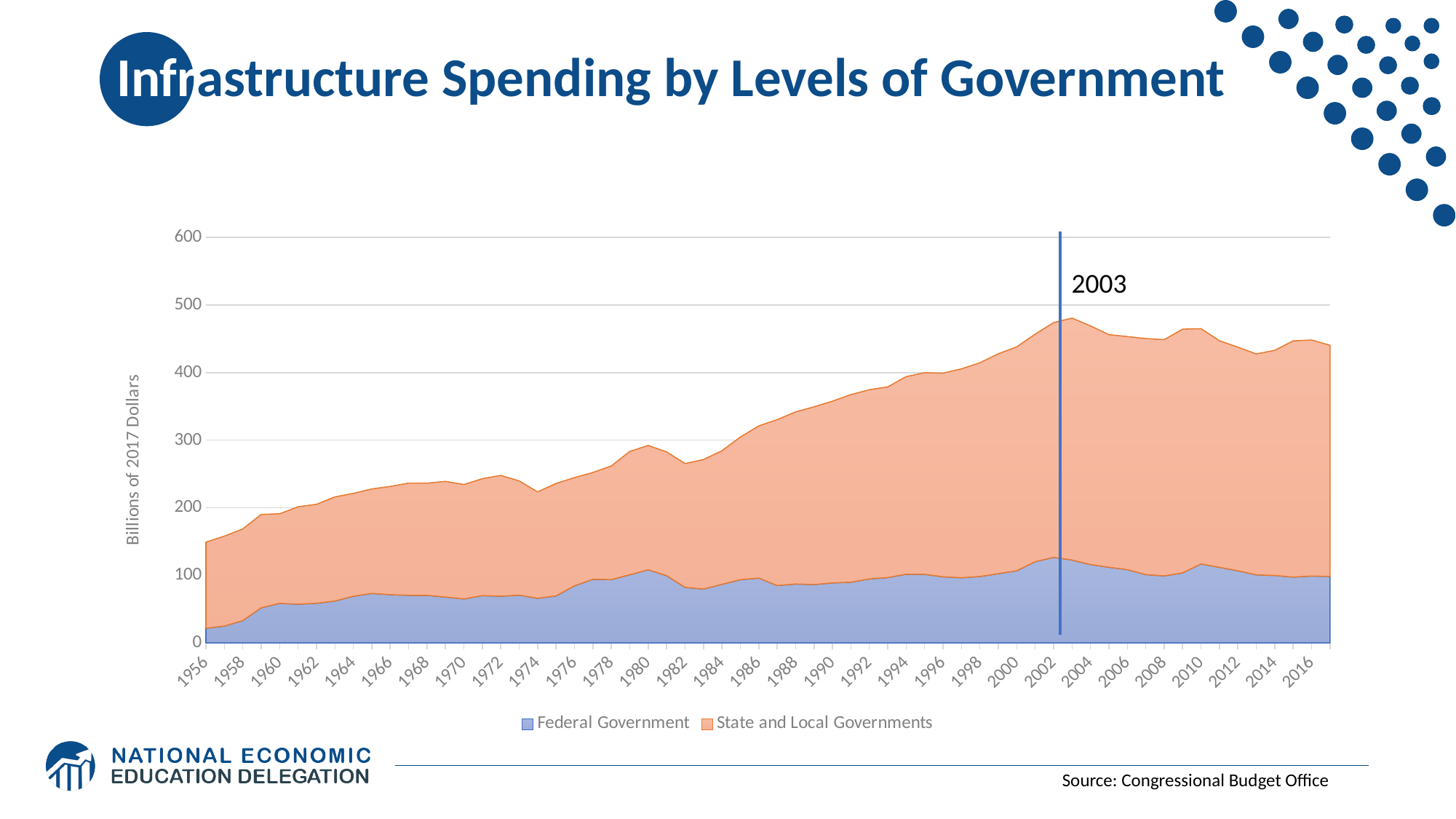
In 2016, which series contributes more spending: Federal Government or State and Local Governments? State and Local Governments What kind of chart is shown on the slide? Stacked area chart Is the Federal Government spending in 1956 greater or less than 100? less What are the two series named in the legend? Federal Government; State and Local Governments Is the total infrastructure spending in 1990 greater or less than 300? greater How many series does the legend list? 2 What is the label on the vertical axis? Billions of 2017 Dollars Which year is marked by the vertical line on the chart? 2003 Does total infrastructure spending generally rise or fall from 1956 to 2002? rise Which year has higher total infrastructure spending, 1956 or 2016? 2016 Is the total infrastructure spending in 2002 greater or less than 400? greater